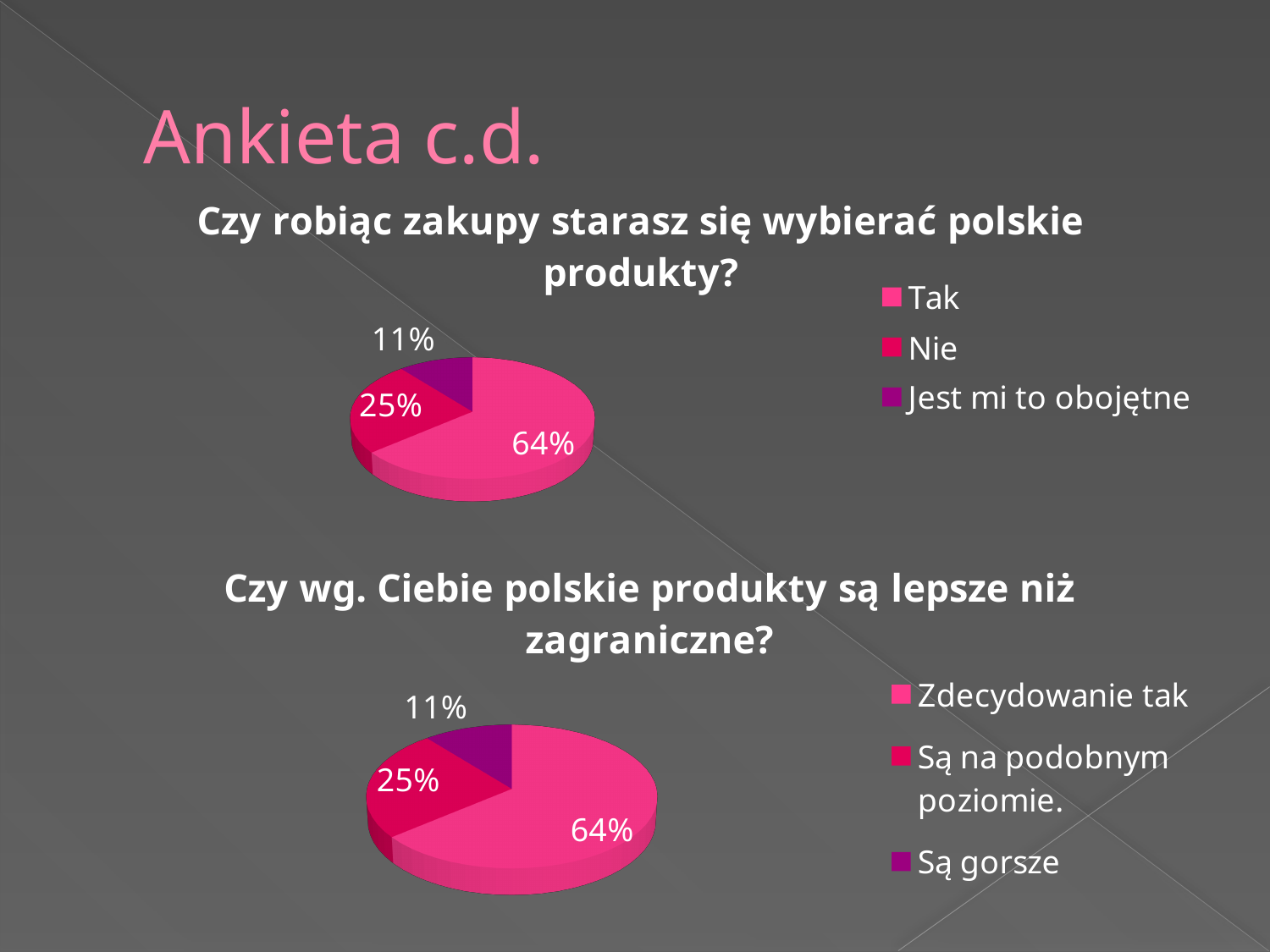
In the top chart ("Czy robiąc zakupy starasz się wybierać polskie produkty?"), what share of the pie is "Jest mi to obojętne"? 11% In the bottom chart ("Czy wg. Ciebie polskie produkty są lepsze niż zagraniczne?"), which is larger, "Są na podobnym poziomie." or "Są gorsze"? Są na podobnym poziomie. In the top chart ("Czy robiąc zakupy starasz się wybierać polskie produkty?"), which category has the largest slice? Tak In the bottom chart ("Czy wg. Ciebie polskie produkty są lepsze niż zagraniczne?"), what share of the pie is "Zdecydowanie tak"? 64% In the top chart ("Czy robiąc zakupy starasz się wybierać polskie produkty?"), which category has the smallest slice? Jest mi to obojętne In the top chart ("Czy robiąc zakupy starasz się wybierać polskie produkty?"), how many categories does the legend list? 3 In the top chart ("Czy robiąc zakupy starasz się wybierać polskie produkty?"), what share of the pie is "Tak"? 64% In the bottom chart ("Czy wg. Ciebie polskie produkty są lepsze niż zagraniczne?"), what is the difference in percentage points between "Zdecydowanie tak" and "Są gorsze"? 53 What type of chart is the top chart on the slide? Pie chart